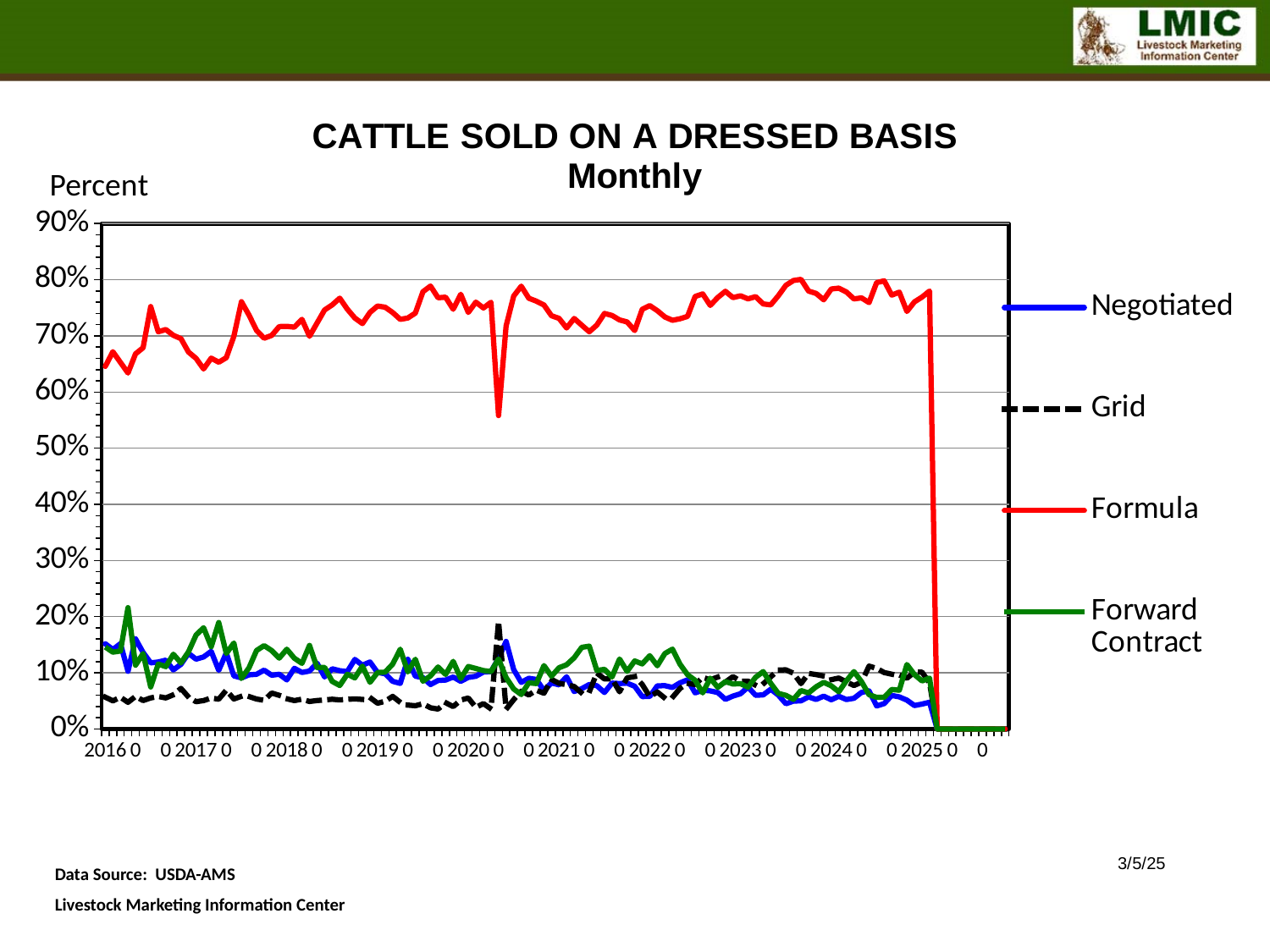
Is the Formula value at the start of 2016 greater or less than 60%? greater Which series is drawn with a dashed line? Grid In 2023, which is larger, the Formula value or the Negotiated value? Formula Which series has the lowest values at the start of 2016? Grid What is the label on the vertical axis? Percent Is the Grid value in 2023 greater or less than 20%? less Does the Negotiated series rise or fall from 2016 to 2024? fall Which series has the highest values across the whole period? Formula Is the Negotiated value in 2024 greater or less than 10%? less What kind of chart is shown on the slide? line chart How many series does the legend list? 4